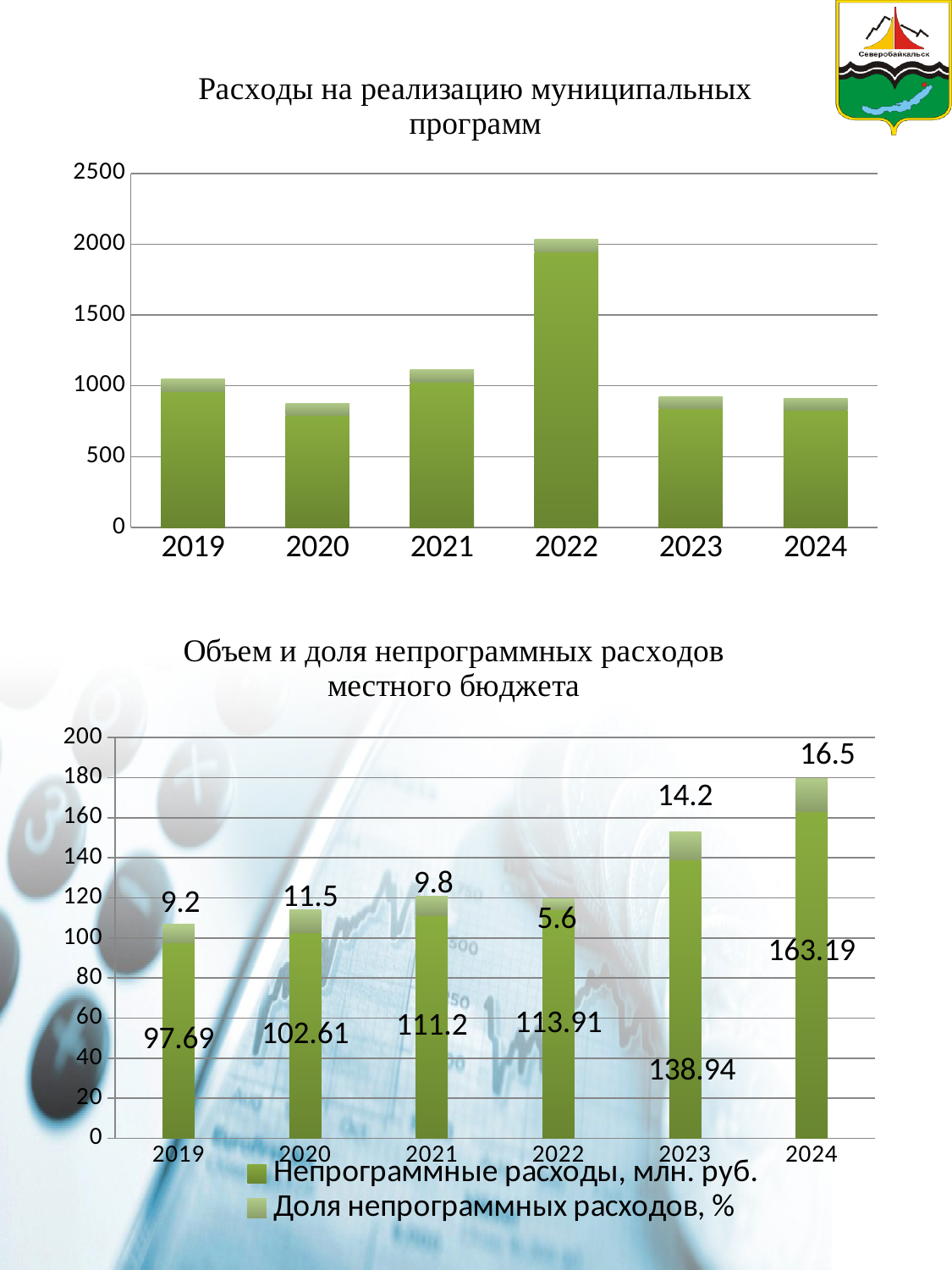
On the bottom chart 'Объем и доля непрограммных расходов местного бюджета', what is the difference between 'Непрограммные расходы, млн. руб.' in 2024 and 2023? 24.25 On the top chart 'Расходы на реализацию муниципальных программ', how many years are shown on the x axis? 6 On the top chart 'Расходы на реализацию муниципальных программ', is the value for 2022 greater or less than 1500? greater What type of chart is the top chart 'Расходы на реализацию муниципальных программ'? bar chart On the top chart 'Расходы на реализацию муниципальных программ', which year has the highest value? 2022 On the bottom chart 'Объем и доля непрограммных расходов местного бюджета', what is the value of 'Доля непрограммных расходов, %' for 2022? 5.6 On the bottom chart 'Объем и доля непрограммных расходов местного бюджета', how many series does the legend list? 2 On the top chart 'Расходы на реализацию муниципальных программ', is the value for 2020 greater or less than 1000? less On the bottom chart 'Объем и доля непрограммных расходов местного бюджета', which is larger: 'Доля непрограммных расходов, %' in 2020 or in 2021? 2020 On the bottom chart 'Объем и доля непрограммных расходов местного бюджета', do the values of 'Непрограммные расходы, млн. руб.' rise or fall from 2019 to 2024? rise On the bottom chart 'Объем и доля непрограммных расходов местного бюджета', what is the value of 'Непрограммные расходы, млн. руб.' for 2024? 163.19 On the bottom chart 'Объем и доля непрограммных расходов местного бюджета', which year has the lowest value of 'Доля непрограммных расходов, %'? 2022